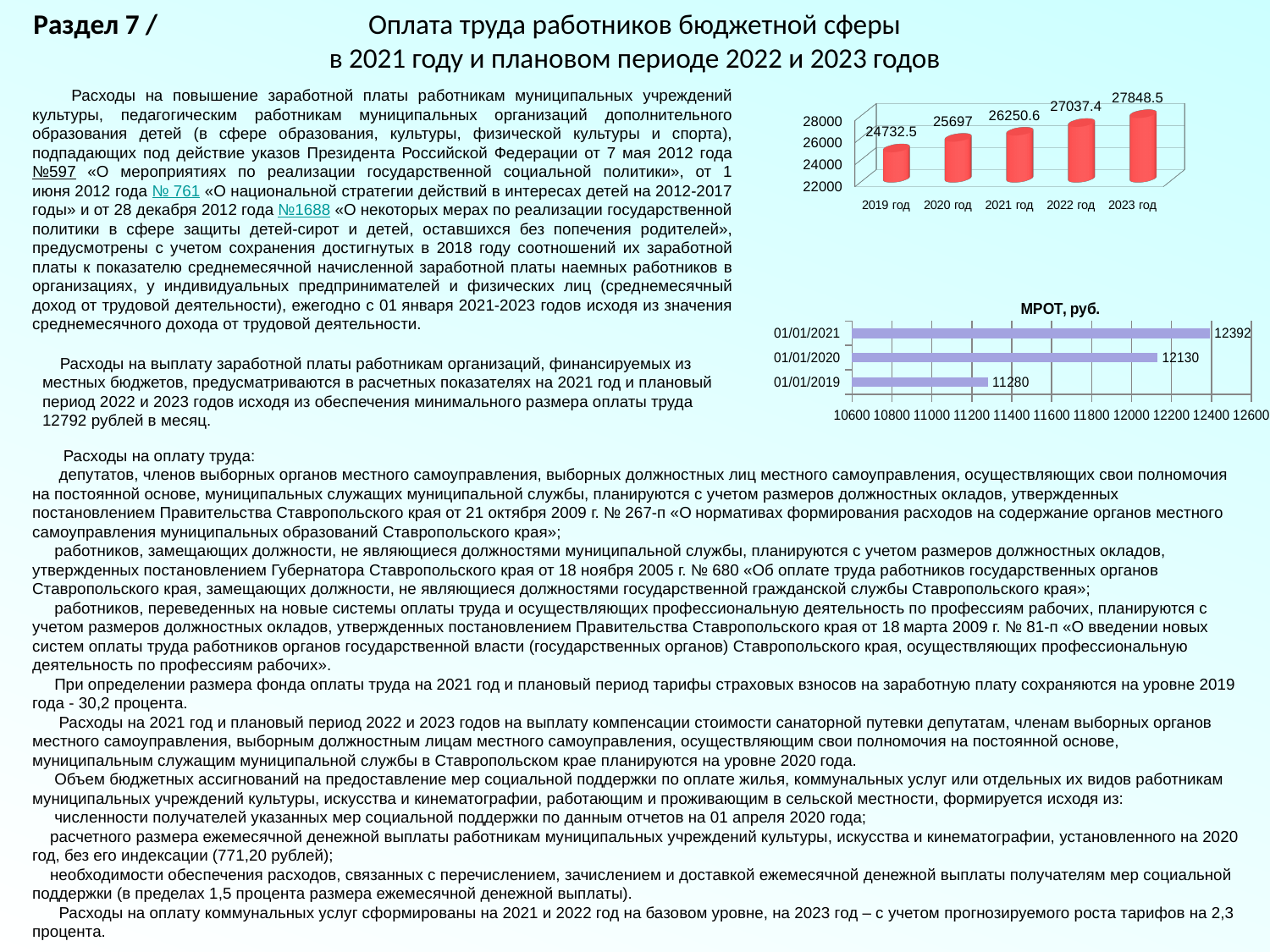
In the chart titled 'МРОТ, руб.', what is the value for 01/01/2019? 11280 In the chart titled 'МРОТ, руб.', what is the difference between the values for 01/01/2021 and 01/01/2019? 1112 In the top-right bar chart, which year has the lowest value? 2019 год In the top-right bar chart, how many years are shown on the x axis? 5 In the top-right bar chart, which year has the highest value? 2023 год In the chart titled 'МРОТ, руб.', which is larger: the value for 01/01/2021 or 01/01/2020? 01/01/2021 What kind of chart is the chart titled 'МРОТ, руб.'? bar chart In the top-right bar chart, what is the difference between the values for 2023 год and 2022 год? 811.1 In the chart titled 'МРОТ, руб.', what is the value for 01/01/2020? 12130 In the top-right bar chart, what is the value for 2019 год? 24732.5 In the top-right bar chart, do the values rise or fall from 2019 год to 2023 год? rise In the top-right bar chart, what is the value for 2021 год? 26250.6